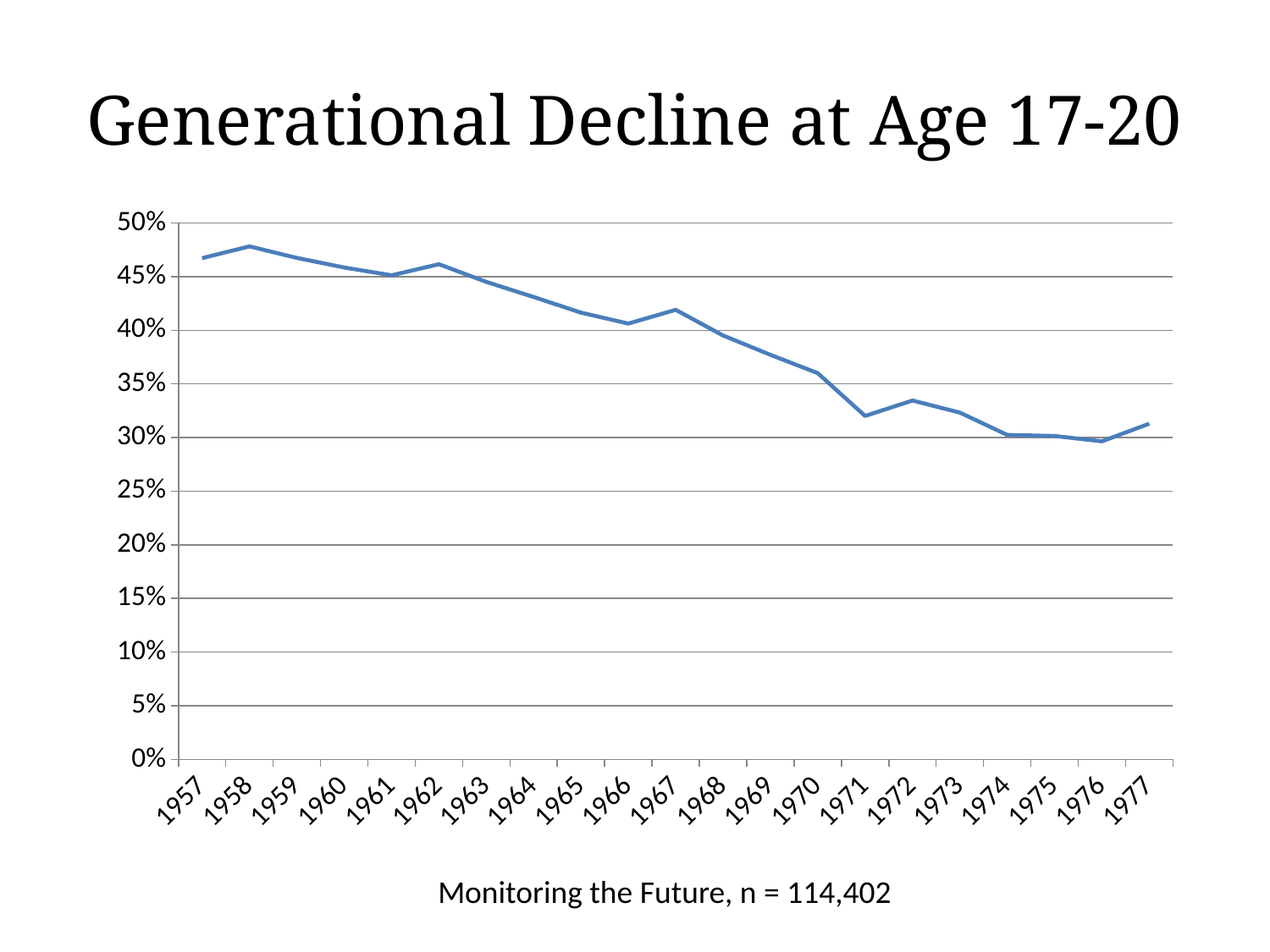
What sample size is given in the note below the chart? n = 114,402 Is the value for 1974 greater or less than 35%? less What kind of chart is shown on the slide? line chart How many years are plotted along the x axis? 21 Is the value for 1957 greater or less than 45%? greater Which is larger, the value for 1957 or the value for 1977? 1957 Which is larger, the value for 1971 or the value for 1972? 1972 Is the value for 1969 greater or less than 35%? greater Which year has the highest value? 1958 Do the values generally rise or fall from 1957 to 1977? fall What is the title of the chart? Generational Decline at Age 17-20